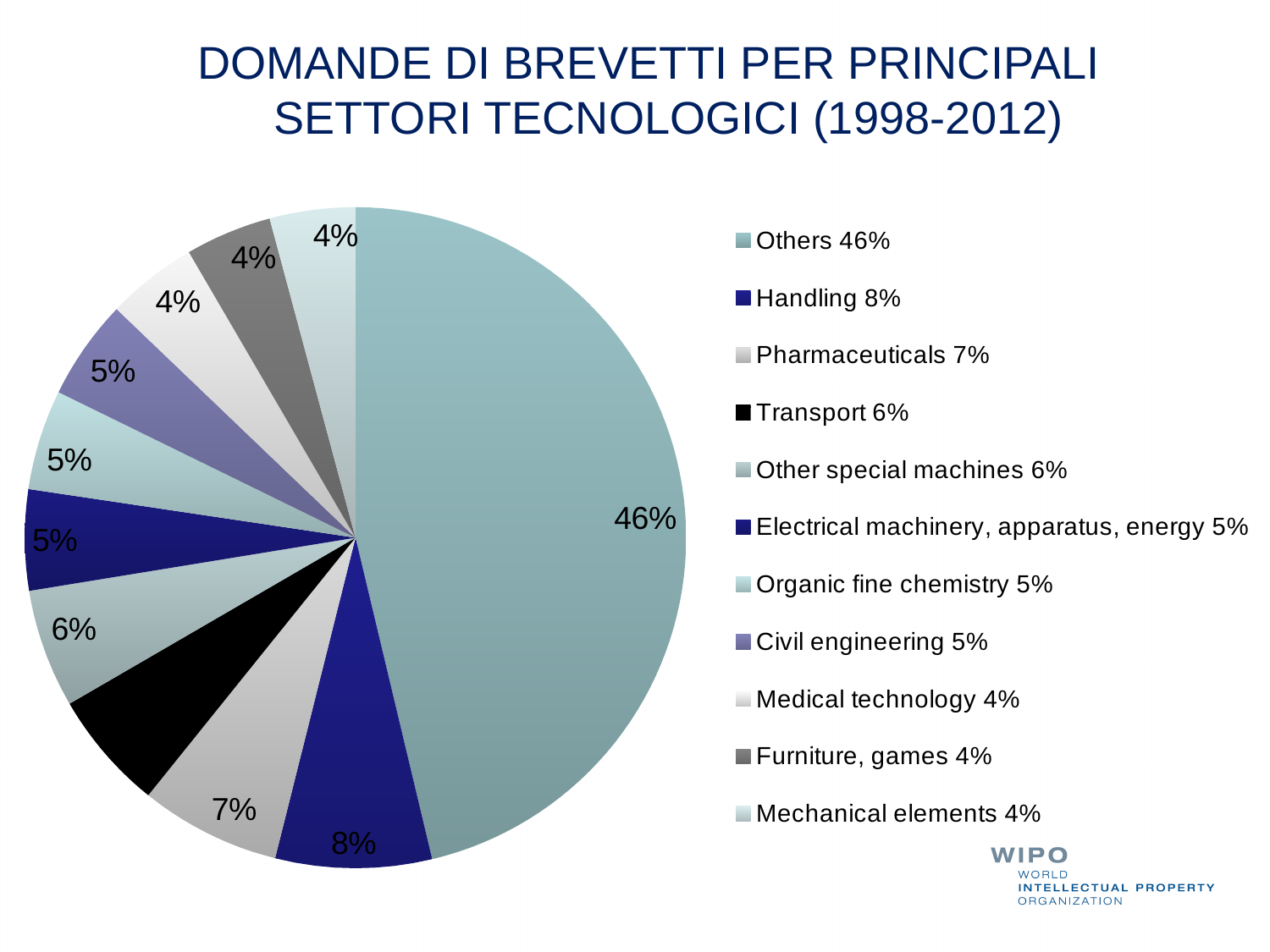
What share of patent applications does the Others slice represent? 46% What is the difference between Pharmaceuticals and Mechanical elements? 3% How many categories does the legend list? 11 What kind of chart is shown on the slide? pie chart What is the combined share of Handling and Pharmaceuticals? 15% What is the value for Civil engineering? 5% What is the value for Handling? 8% Which is larger, Transport or Medical technology? Transport What is the value for Pharmaceuticals? 7% Which category has the largest slice of the pie? Others What is the title of the chart on the slide? DOMANDE DI BREVETTI PER PRINCIPALI SETTORI TECNOLOGICI (1998-2012) What is the difference between the Others slice and the Handling slice? 38%